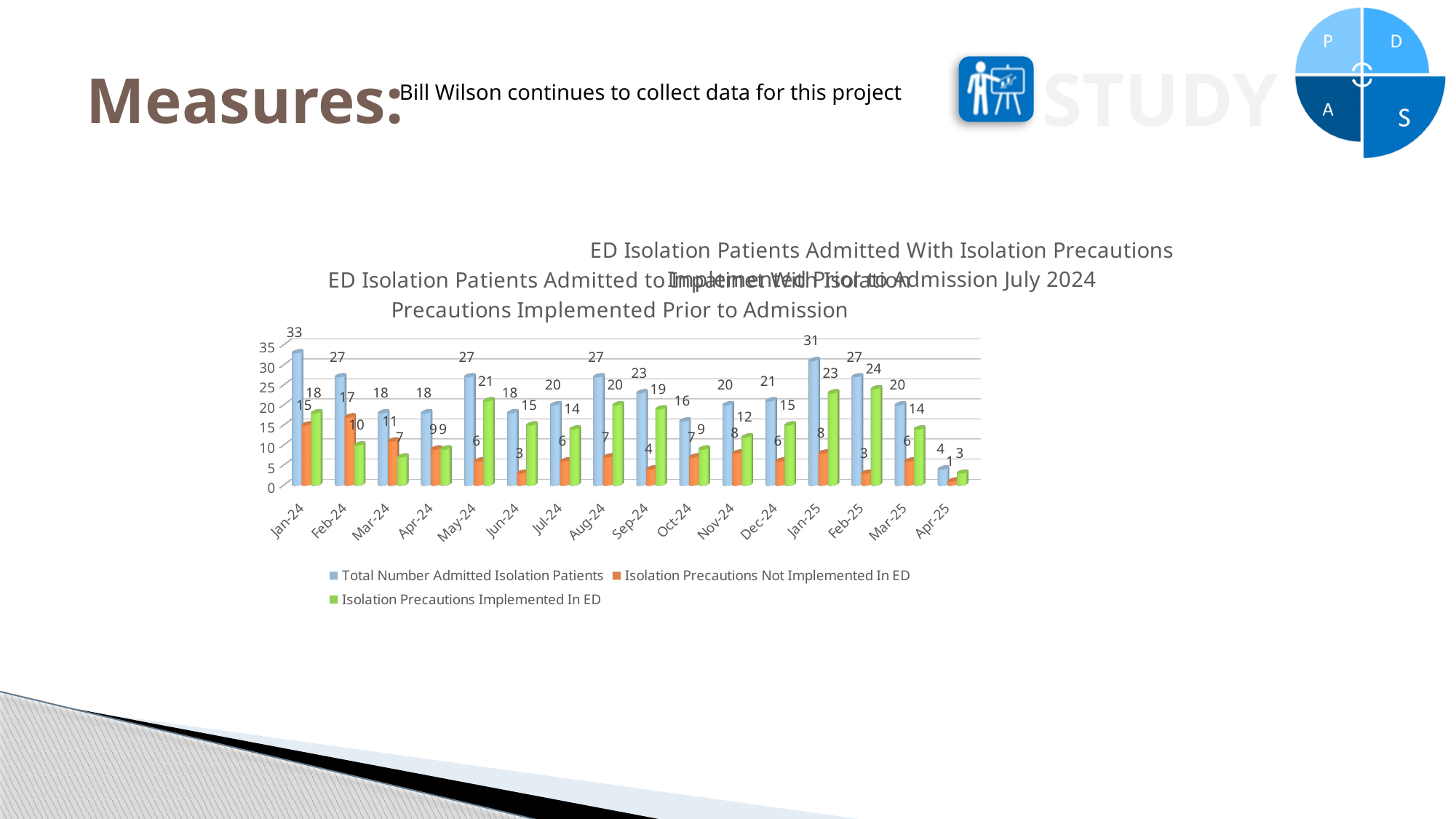
What is the Total Number Admitted Isolation Patients for Jan-24? 33 What kind of chart is shown on the slide? bar chart What is the value for Isolation Precautions Not Implemented In ED in Feb-24? 17 Which series is shown in green in the legend? Isolation Precautions Implemented In ED Which month has the lowest Total Number Admitted Isolation Patients? Apr-25 Is the Total Number Admitted Isolation Patients for Jan-25 greater or less than 25? greater How many months are shown on the x axis? 16 Which month has the highest Total Number Admitted Isolation Patients? Jan-24 In Feb-24, which is larger: Isolation Precautions Not Implemented In ED or Isolation Precautions Implemented In ED? Isolation Precautions Not Implemented In ED How many Isolation Precautions Implemented In ED patients are shown for Feb-25? 24 What is the difference between Isolation Precautions Implemented In ED and Isolation Precautions Not Implemented In ED in May-24? 15 How many series does the legend list? 3